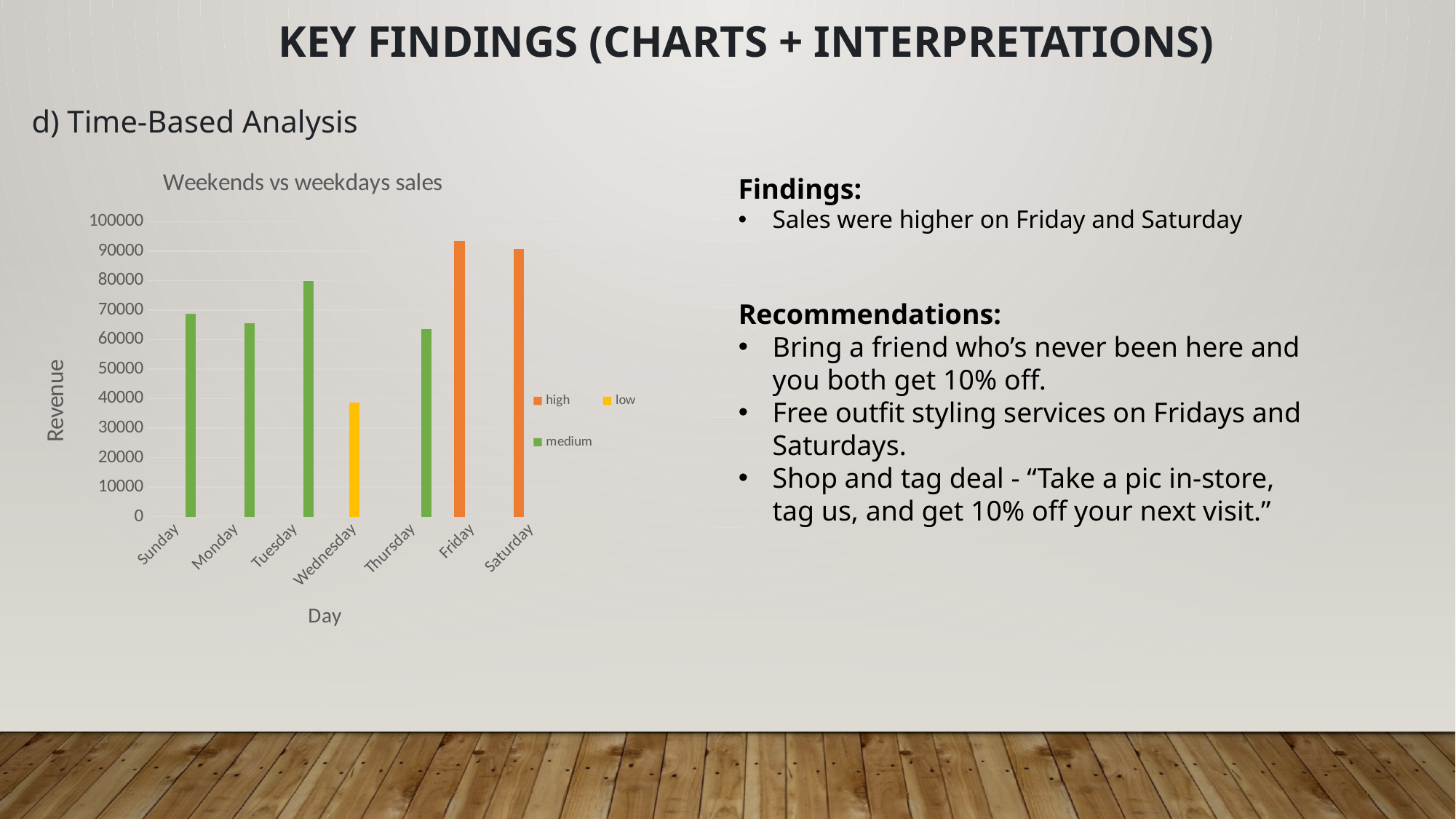
What is the label of the y axis of the chart? Revenue What is the title of the chart? Weekends vs weekdays sales How many days are shown on the x axis of the chart? 7 Which has higher revenue, Tuesday or Monday? Tuesday Which has higher revenue, Wednesday or Thursday? Thursday What type of chart is shown on the slide? bar chart Which day has the lowest revenue in the chart? Wednesday Is the revenue for Tuesday greater or less than 70000? greater How many series does the chart legend list? 3 Is the revenue for Monday greater or less than 70000? less Is the revenue for Wednesday greater or less than 50000? less